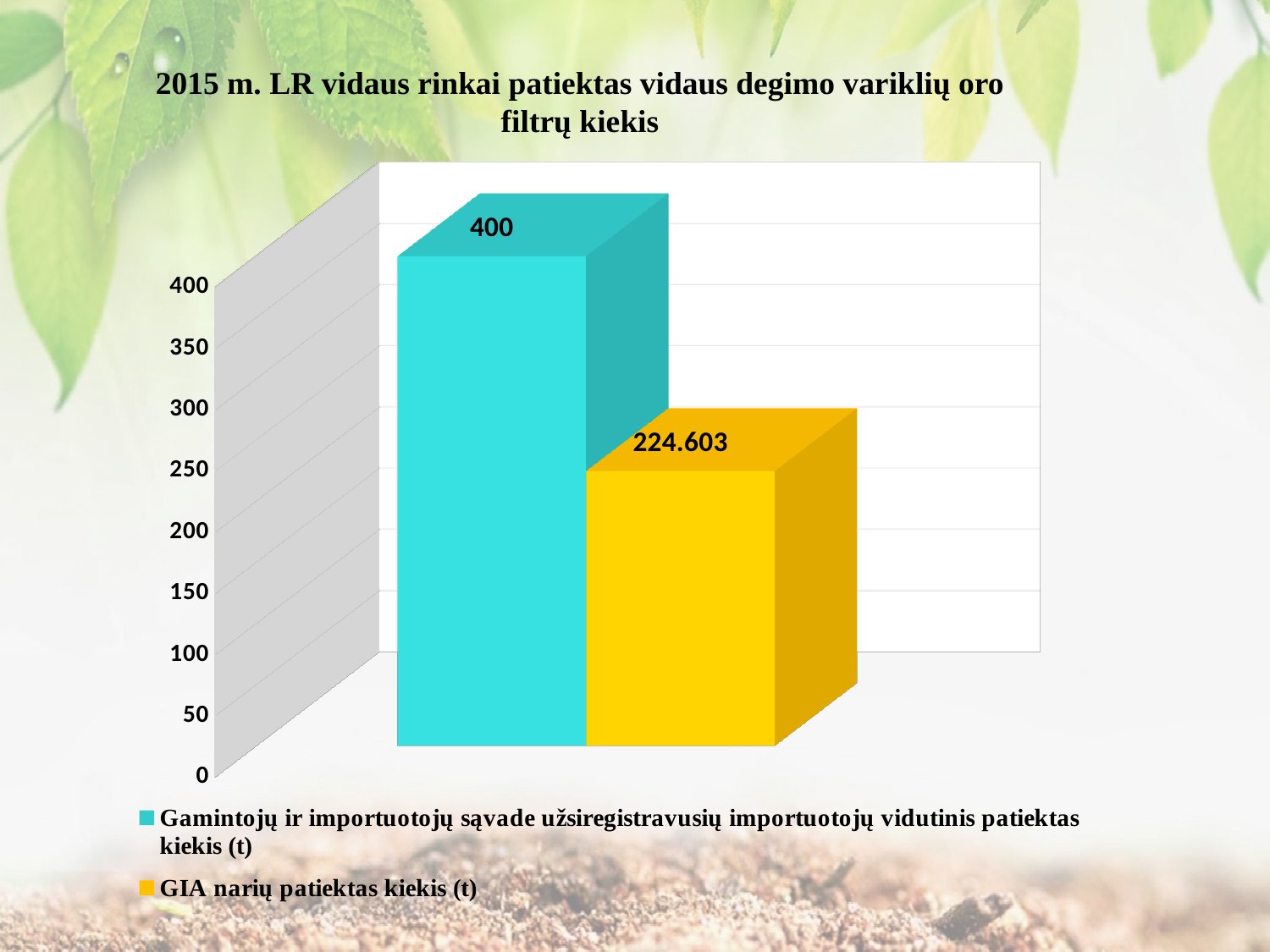
How many series does the legend list? 2 What is the title of the chart? 2015 m. LR vidaus rinkai patiektas vidaus degimo variklių oro filtrų kiekis Which series has the lowest value? GIA narių patiektas kiekis (t) How many bars are plotted on the chart? 2 Which series has the highest value? Gamintojų ir importuotojų sąvade užsiregistravusių importuotojų vidutinis patiektas kiekis (t) What kind of chart is shown on the slide? Bar chart Which is larger: the value for 'GIA narių patiektas kiekis (t)' or the value for 'Gamintojų ir importuotojų sąvade užsiregistravusių importuotojų vidutinis patiektas kiekis (t)'? Gamintojų ir importuotojų sąvade užsiregistravusių importuotojų vidutinis patiektas kiekis (t) Is the value for 'Gamintojų ir importuotojų sąvade užsiregistravusių importuotojų vidutinis patiektas kiekis (t)' greater or less than 350? greater What is the value for 'Gamintojų ir importuotojų sąvade užsiregistravusių importuotojų vidutinis patiektas kiekis (t)'? 400 What is the value for 'GIA narių patiektas kiekis (t)'? 224.603 What is the difference between the value for 'Gamintojų ir importuotojų sąvade užsiregistravusių importuotojų vidutinis patiektas kiekis (t)' and the value for 'GIA narių patiektas kiekis (t)'? 175.397 Is the value for 'GIA narių patiektas kiekis (t)' greater or less than 250? less